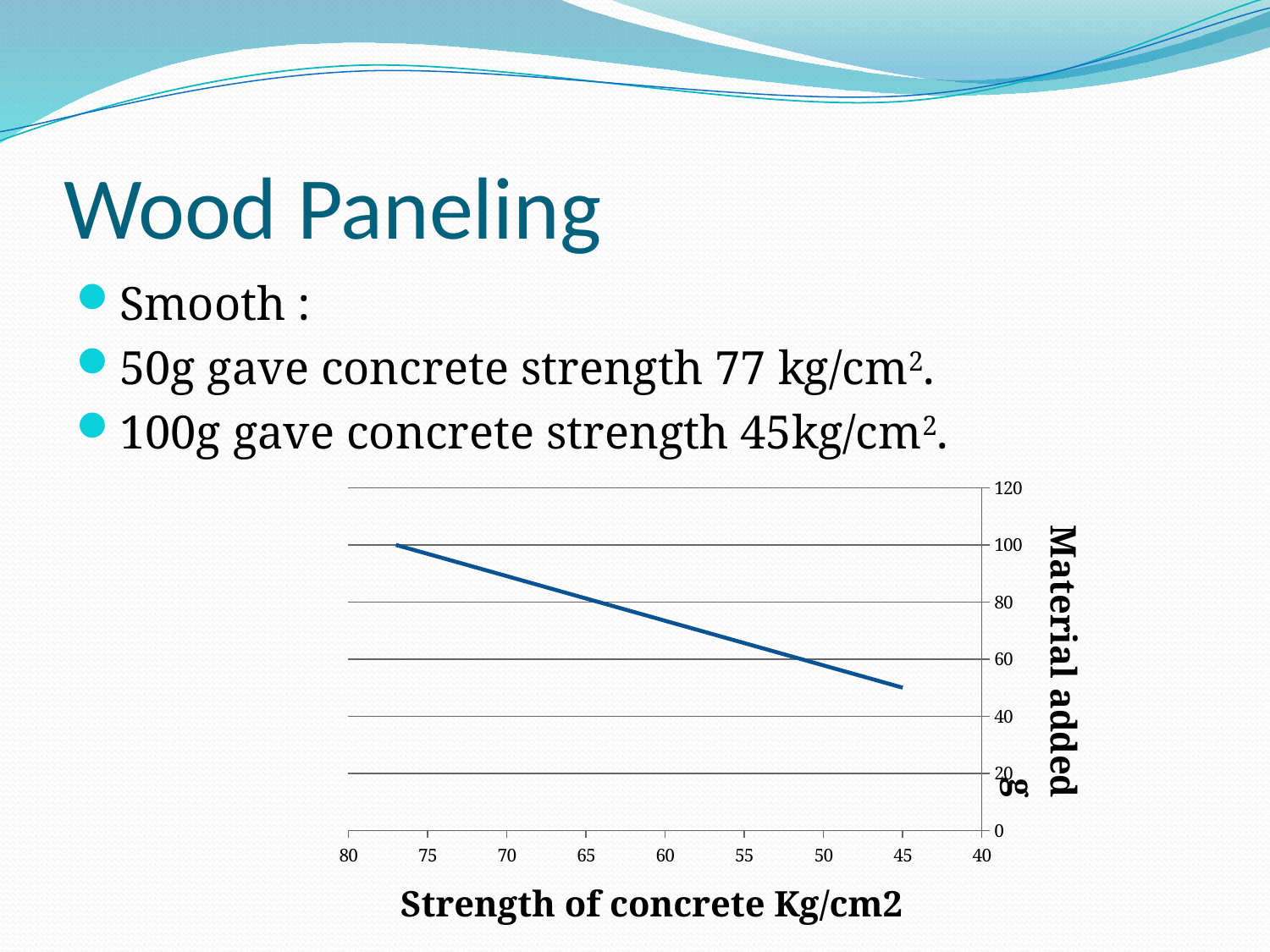
What is the title of the x axis of the chart? Strength of concrete Kg/cm2 Which point on the line has the lowest material added, the one at strength 45 or the one near strength 77? the one at strength 45 Is the material added at a concrete strength of 45 greater or less than 60? less Which end of the line shows more material added, the left end or the right end? left end Does the line in the chart rise or fall from left to right? falls Is the material added at a concrete strength of 45 greater or less than 40? greater Is the material added at the left end of the line (near strength 77) greater or less than 80? greater How many data points does the line in the chart connect? 2 What is the title of the y axis of the chart? Material added g What kind of chart is shown on the slide? line chart